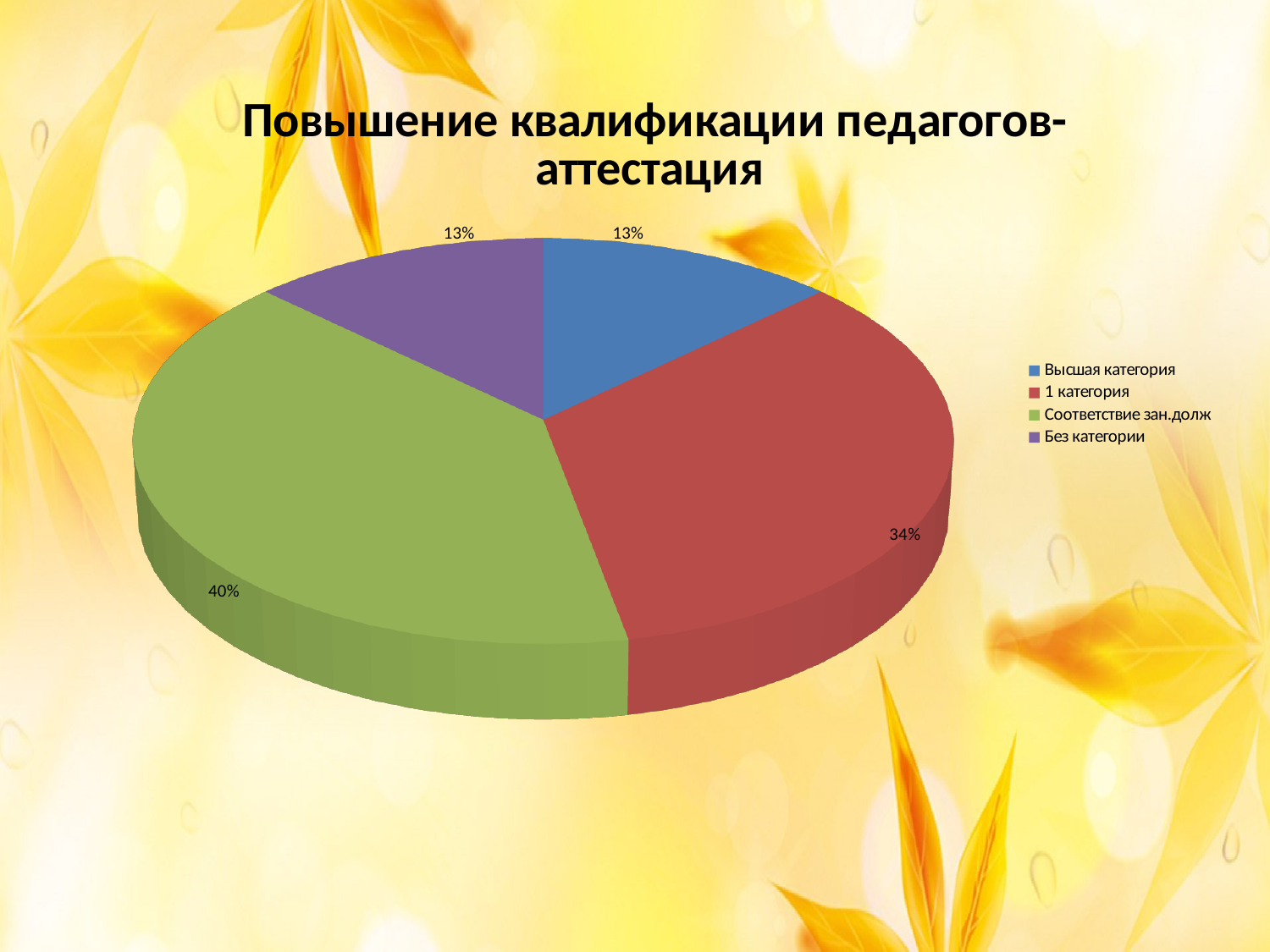
What is the difference in percentage points between "Соответствие зан.долж" and "1 категория"? 6 percentage points What is the difference in percentage points between "1 категория" and "Без категории"? 21 percentage points Which category has the largest slice of the pie? Соответствие зан.долж What type of chart is shown on the slide? Pie chart What share of the pie does "Соответствие зан.долж" represent? 40% Which is larger, the slice for "1 категория" or the slice for "Высшая категория"? 1 категория What share of the pie does "1 категория" represent? 34% How many categories does the pie chart have? 4 Which colour represents "1 категория" in the legend? Red What is the value shown for "Высшая категория"? 13% What is the title of the slide containing the chart? Повышение квалификации педагогов-аттестация What is the value shown for "Без категории"? 13%